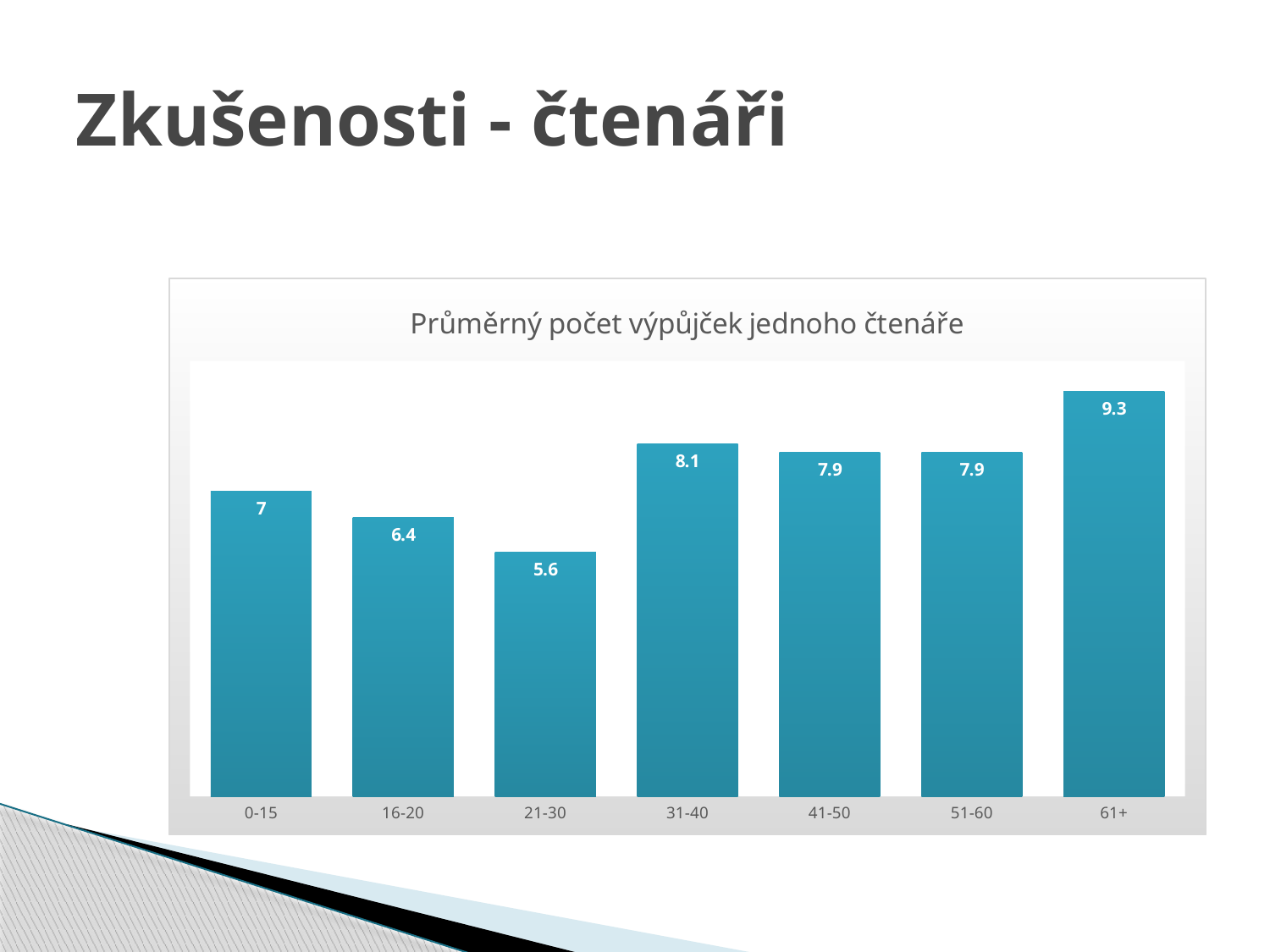
What is the value shown for the 61+ age group? 9.3 What is the difference between the values for 31-40 and 16-20? 1.7 Which two age groups have the same value of 7.9? 41-50 and 51-60 What is the average number of loans per reader for the 0-15 age group? 7 Which age group has the lowest average number of loans per reader? 21-30 Which age group has the highest average number of loans per reader? 61+ What is the difference between the values for 61+ and 21-30? 3.7 What is the title of the chart? Průměrný počet výpůjček jednoho čtenáře What is the value shown for the 21-30 age group? 5.6 Which is larger, the value for 0-15 or the value for 16-20? 0-15 How many age groups are shown on the chart? 7 What kind of chart is shown on the slide? Bar chart